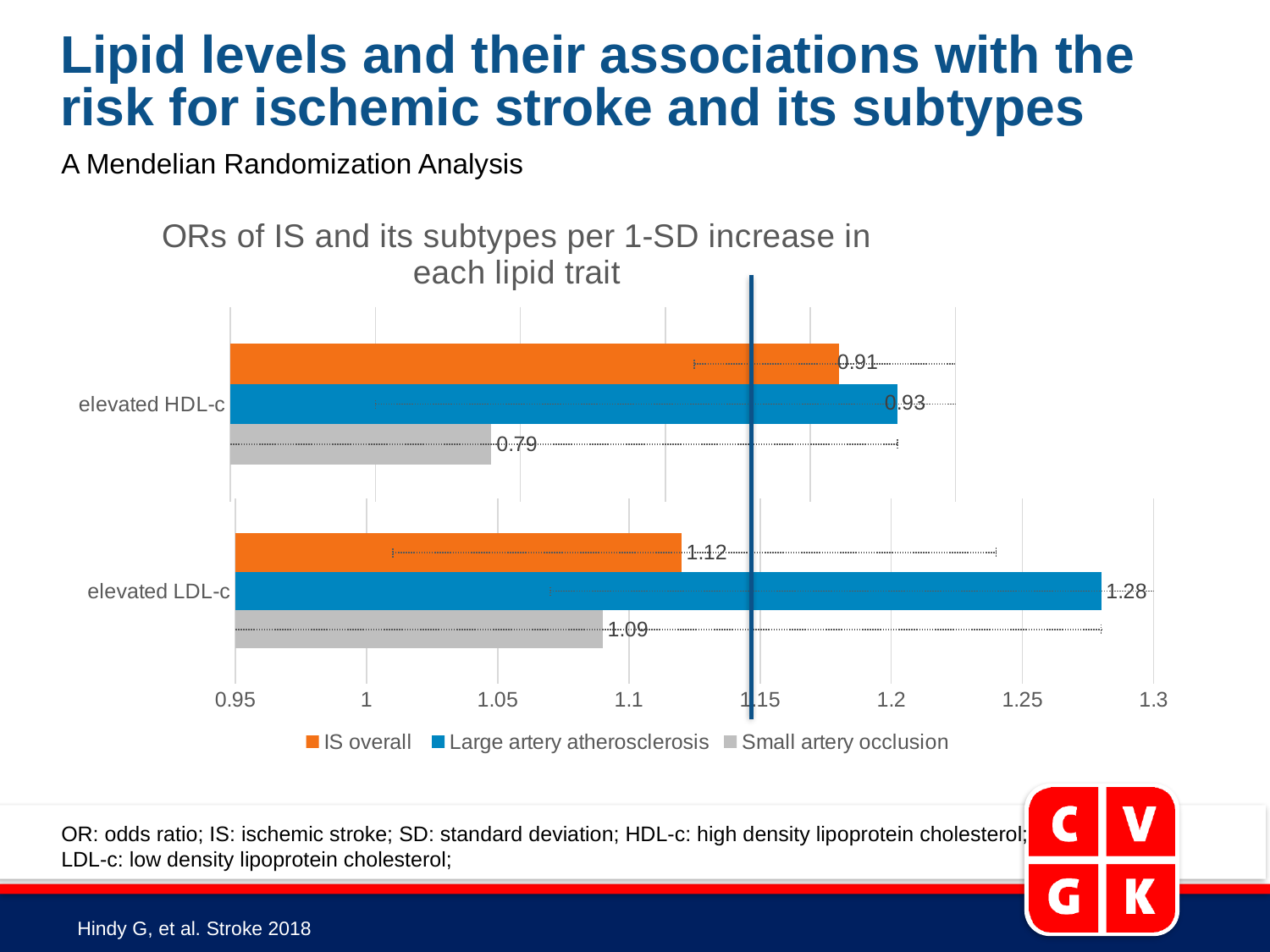
How many series does the legend list? 3 What type of chart is shown on the slide? Bar chart Which series has the lowest OR for elevated HDL-c? Small artery occlusion What is the OR for Small artery occlusion for elevated LDL-c? 1.09 What is the OR for Large artery atherosclerosis for elevated LDL-c? 1.28 What is the difference between the Large artery atherosclerosis OR and the IS overall OR for elevated LDL-c? 0.16 Which is larger for elevated HDL-c: the OR for Large artery atherosclerosis or the OR for Small artery occlusion? Large artery atherosclerosis What is the OR for Small artery occlusion for elevated HDL-c? 0.79 What is the OR for IS overall for elevated HDL-c? 0.91 How many lipid trait categories are shown on the chart? 2 What is the OR for IS overall for elevated LDL-c? 1.12 Which series has the highest OR for elevated LDL-c? Large artery atherosclerosis